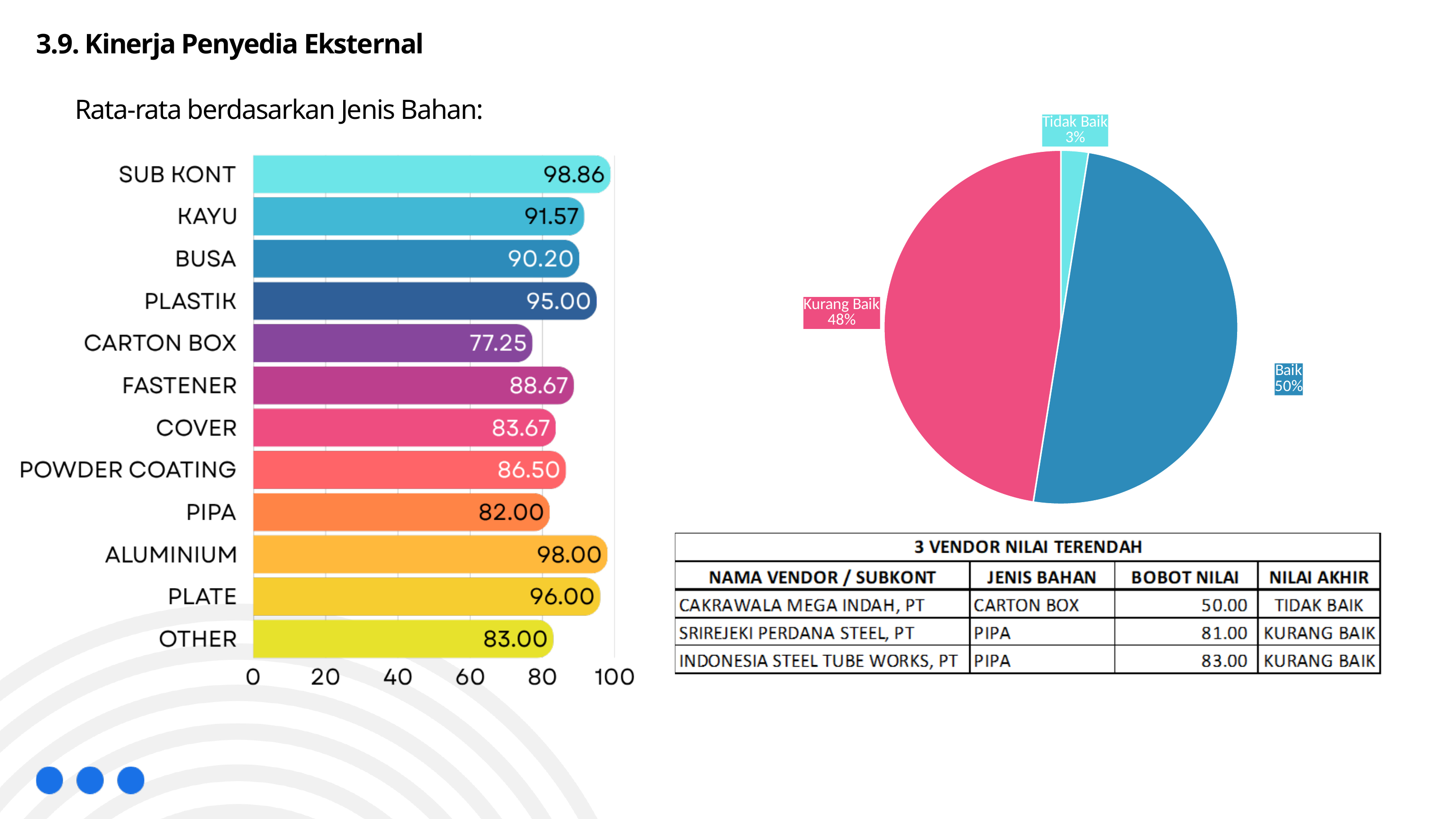
How many slices does the pie chart on the right have? 3 What kind of chart is the chart on the left of the slide? Bar chart In the bar chart on the left, what is the value for POWDER COATING? 86.50 In the bar chart on the left, what is the value for CARTON BOX? 77.25 In the pie chart on the right, what share does Kurang Baik have? 48% In the bar chart on the left, what is the difference between the values for ALUMINIUM and PIPA? 16.00 In the bar chart on the left, which category has the lowest value? CARTON BOX In the bar chart on the left, what is the value for SUB KONT? 98.86 In the bar chart on the left, which category has the highest value? SUB KONT How many categories does the bar chart on the left show? 12 In the bar chart on the left, which is larger, the value for KAYU or the value for BUSA? KAYU In the pie chart on the right, which slice is the smallest? Tidak Baik